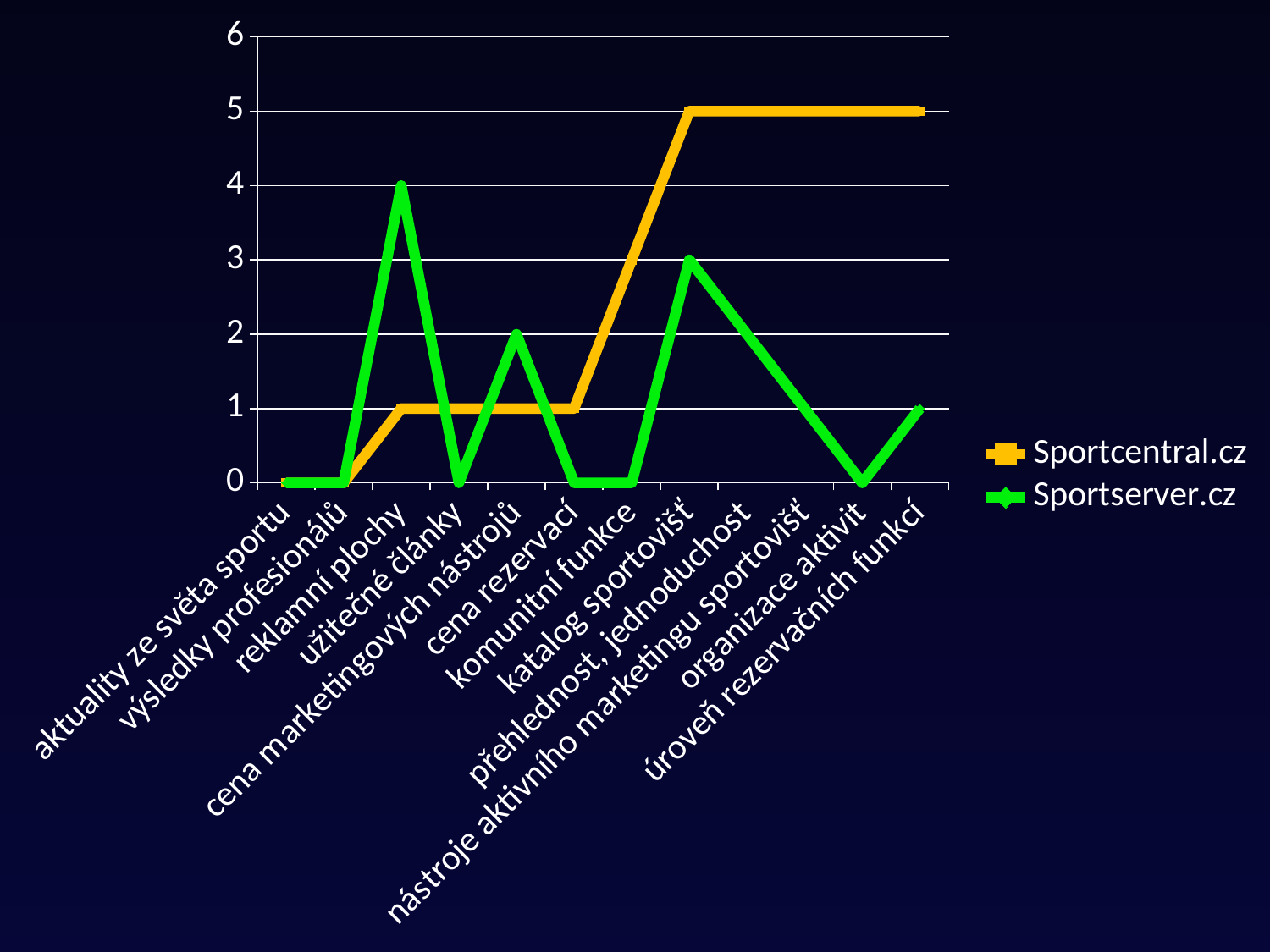
What is the difference between Sportcentral.cz and Sportserver.cz for úroveň rezervačních funkcí? 4 For reklamní plochy, which series has the higher value, Sportcentral.cz or Sportserver.cz? Sportserver.cz What is the value for Sportserver.cz for úroveň rezervačních funkcí? 1 What kind of chart is shown on the slide? line chart For which category does Sportserver.cz reach its highest value? reklamní plochy Which two series are listed in the legend? Sportcentral.cz and Sportserver.cz How many categories are shown on the x axis? 12 What is the value for Sportserver.cz for cena marketingových nástrojů? 2 How many series does the legend list? 2 What is the value for Sportcentral.cz for reklamní plochy? 1 What is the value for Sportcentral.cz for katalog sportovišť? 5 What is the value for Sportserver.cz for reklamní plochy? 4